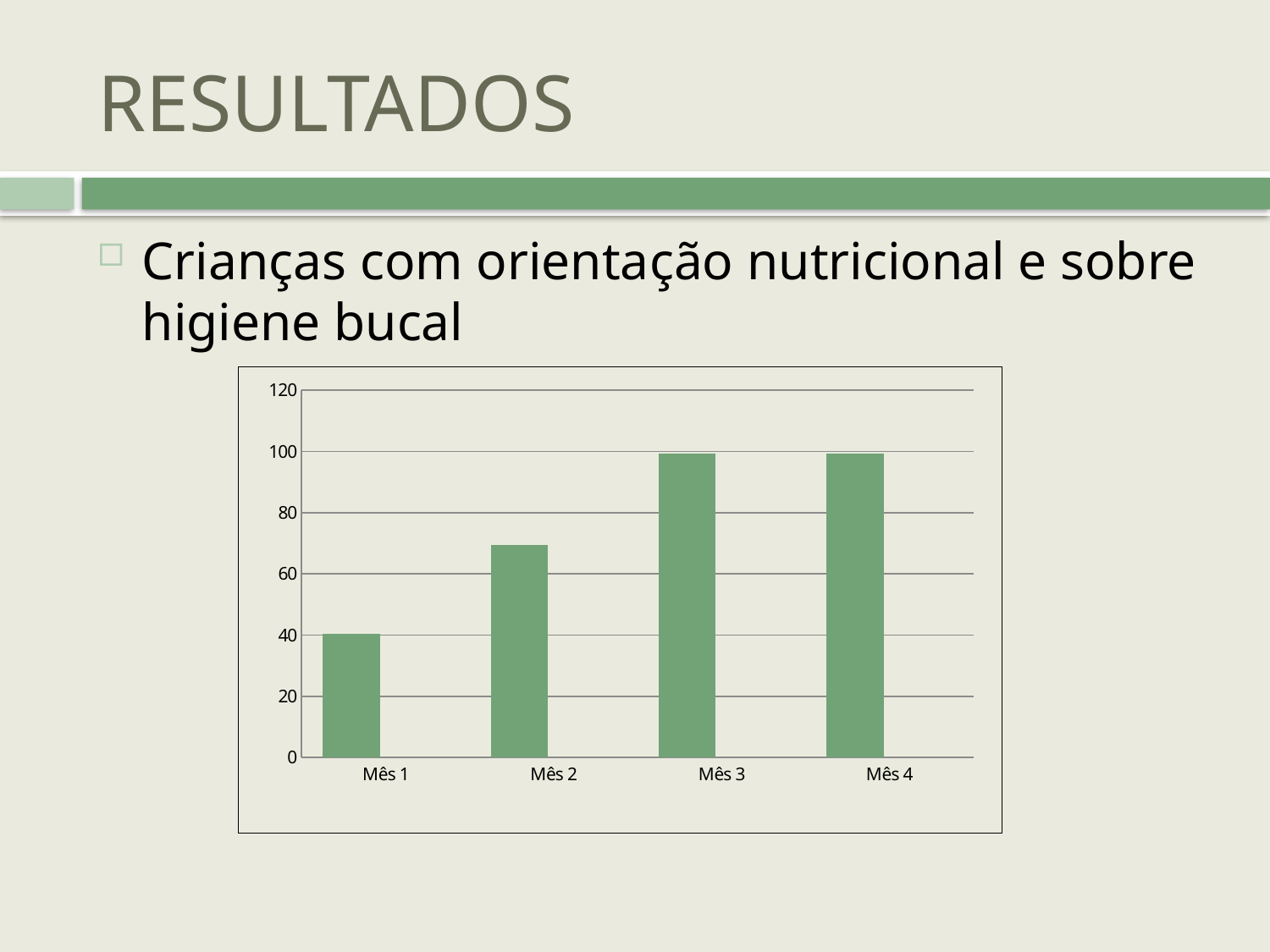
Is the value for Mês 2 greater or less than 80? less Which category has the lowest value in the chart? Mês 1 Is the value for Mês 3 greater or less than 80? greater Which is larger, the value for Mês 2 or the value for Mês 3? Mês 3 Do the values rise or fall from Mês 1 to Mês 3? rise Is the value for Mês 1 greater or less than 60? less What kind of chart is shown on the slide? bar chart What is the highest value shown on the vertical axis of the chart? 120 How many categories are shown on the x axis of the chart? 4 Which is larger, the value for Mês 1 or the value for Mês 2? Mês 2